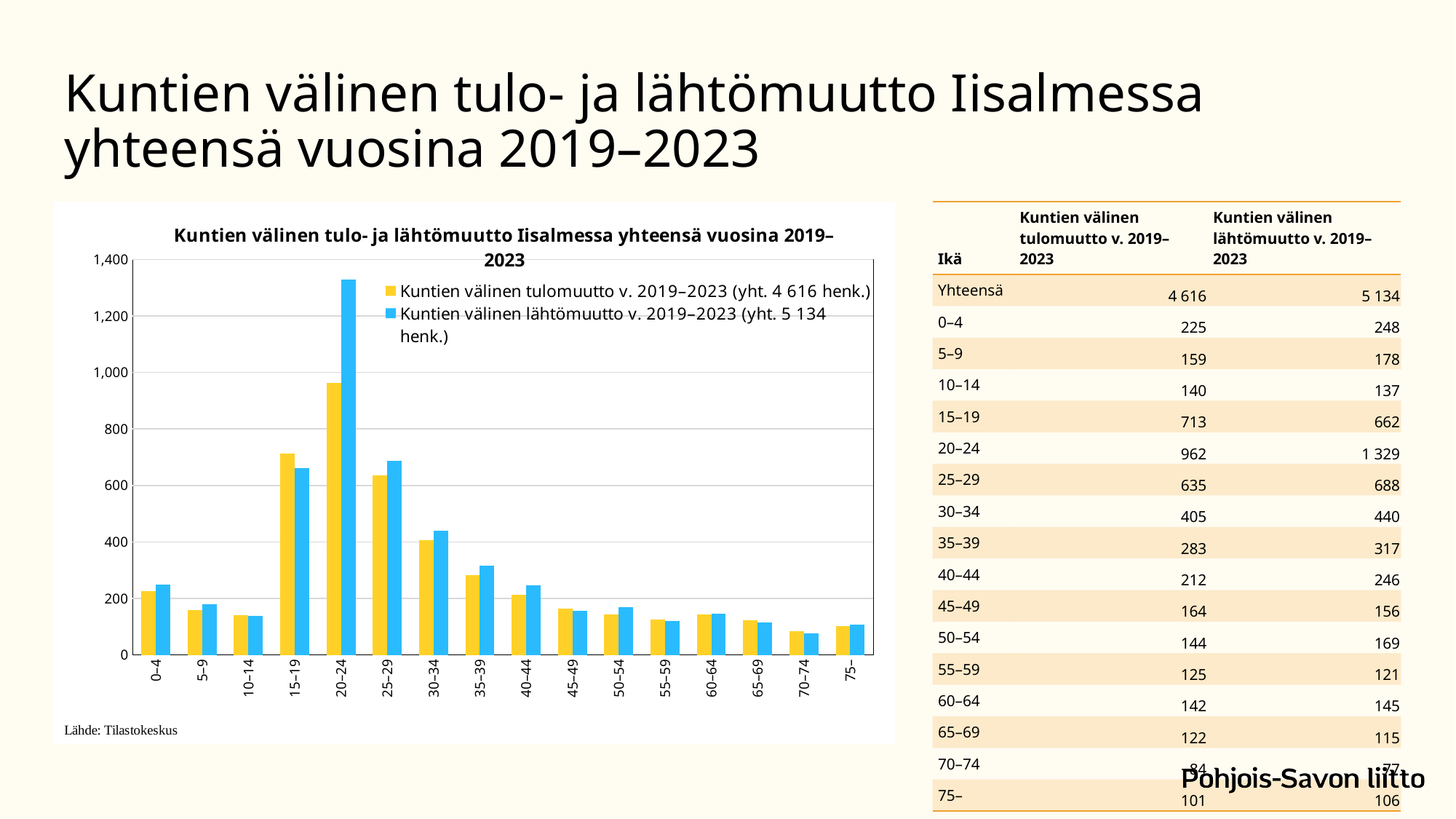
What kind of chart is shown on the slide? bar chart What is the difference between lähtömuutto and tulomuutto for the 20–24 age group? 367 How many age groups are shown on the x axis of the chart? 16 Which age group has the highest value for Kuntien välinen lähtömuutto v. 2019–2023? 20–24 For the 15–19 age group, which is larger: tulomuutto or lähtömuutto? tulomuutto Which age group has the lowest value for Kuntien välinen tulomuutto v. 2019–2023? 70–74 What colour are the bars for Kuntien välinen lähtömuutto v. 2019–2023? blue How many series does the chart legend list? 2 What is the value of Kuntien välinen tulomuutto v. 2019–2023 for the 15–19 age group? 713 What is the value of Kuntien välinen lähtömuutto v. 2019–2023 for the 20–24 age group? 1 329 Is the value of Kuntien välinen lähtömuutto v. 2019–2023 for the 25–29 age group greater or less than 600? greater Do the values for Kuntien välinen tulomuutto v. 2019–2023 rise or fall from the 20–24 age group to the 40–44 age group? fall